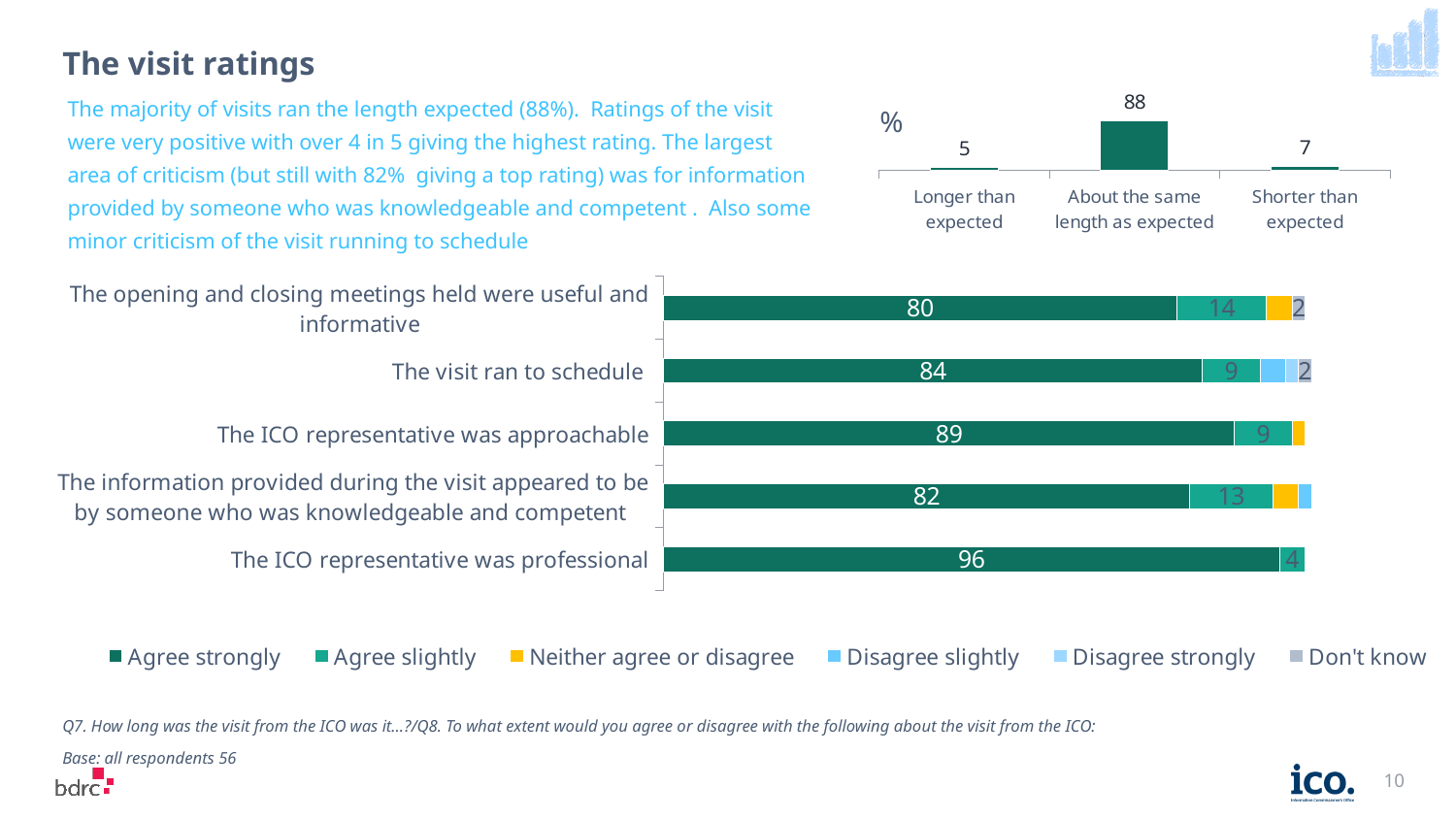
In the bottom stacked bar chart, which statement has the lowest 'Agree strongly' value? The opening and closing meetings held were useful and informative In the top-right chart on visit length, what is the difference between 'About the same length as expected' and 'Longer than expected'? 83 What type of chart is the bottom chart on the slide? Stacked bar chart In the top-right chart on visit length, what is the value for 'Shorter than expected'? 7 In the bottom stacked bar chart, is the 'Agree strongly' value larger for 'The visit ran to schedule' or for 'The ICO representative was approachable'? The ICO representative was approachable In the top-right chart on visit length, what percentage of visits were about the same length as expected? 88 In the bottom stacked bar chart, what is the 'Agree slightly' value for 'The opening and closing meetings held were useful and informative'? 14 In the top-right chart on visit length, how many categories are shown? 3 In the bottom stacked bar chart, which statement has the highest 'Agree strongly' value? The ICO representative was professional In the bottom stacked bar chart, how many series does the legend list? 6 In the top-right chart on visit length, which category has the lowest value? Longer than expected In the bottom stacked bar chart, what is the 'Agree strongly' value for 'The ICO representative was professional'? 96